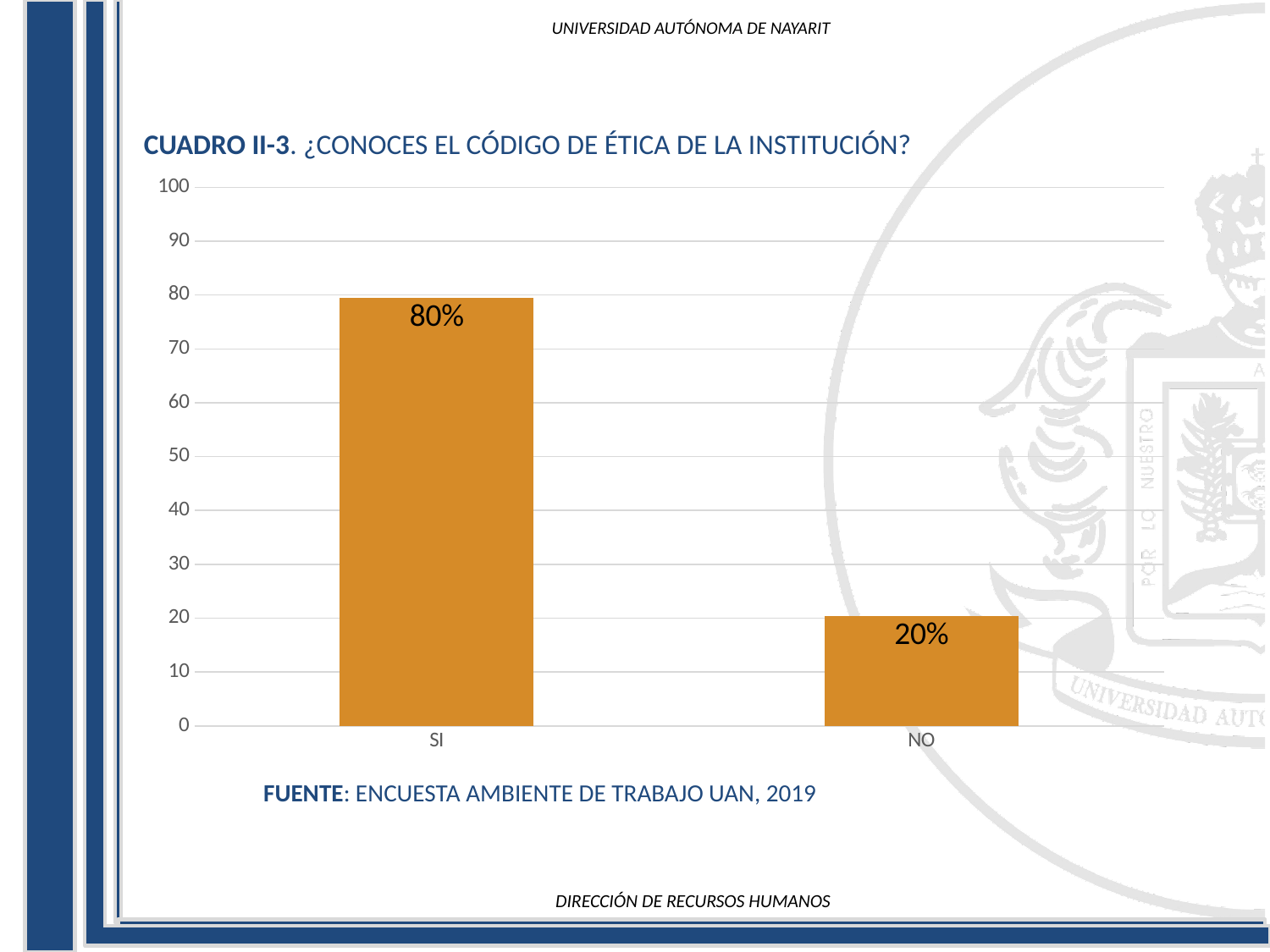
What is the source cited below the chart? ENCUESTA AMBIENTE DE TRABAJO UAN, 2019 What is the title of the chart? CUADRO II-3. ¿CONOCES EL CÓDIGO DE ÉTICA DE LA INSTITUCIÓN? How many categories are shown on the x axis? 2 Which is larger, the value for SI or the value for NO? SI What is the value for NO? 20% Is the value for SI greater or less than 50? greater Is the value for NO greater or less than 30? less What is the difference between the values for SI and NO? 60% Which category has the lowest value? NO Which category has the highest value? SI What is the value for SI? 80% What kind of chart is shown on the slide? bar chart